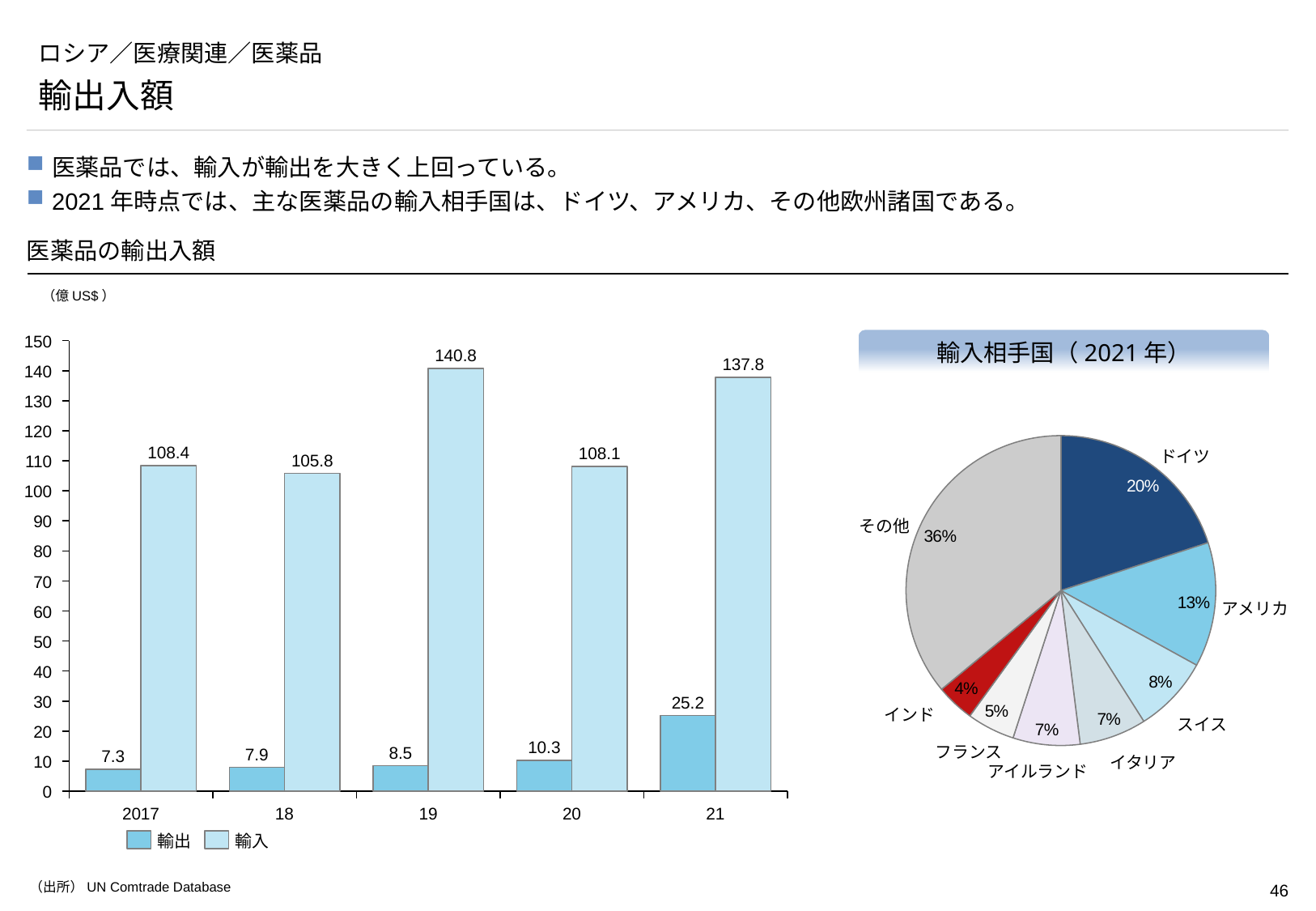
In the pie chart 輸入相手国（2021年）, what share does ドイツ have? 20% In the pie chart 輸入相手国（2021年）, how many slices are there? 8 In the bar chart 医薬品の輸出入額, does the 輸出 value rise or fall from 2017 to 2021? rise In the bar chart 医薬品の輸出入額, what is the difference between 輸入 and 輸出 in 2021? 112.6 In the pie chart 輸入相手国（2021年）, which named country has the smallest share? インド In the bar chart 医薬品の輸出入額, what is the value of 輸出 in 2021? 25.2 In the bar chart 医薬品の輸出入額, is the 輸入 value for 2020 greater or less than 100? greater In the bar chart 医薬品の輸出入額, which year has the lowest 輸出 value? 2017 In the bar chart 医薬品の輸出入額, how many series does the legend list? 2 In the bar chart 医薬品の輸出入額, which year has the highest 輸入 value? 2019 What type of chart is 輸入相手国（2021年）? pie chart In the bar chart 医薬品の輸出入額, what is the value of 輸入 in 2019? 140.8